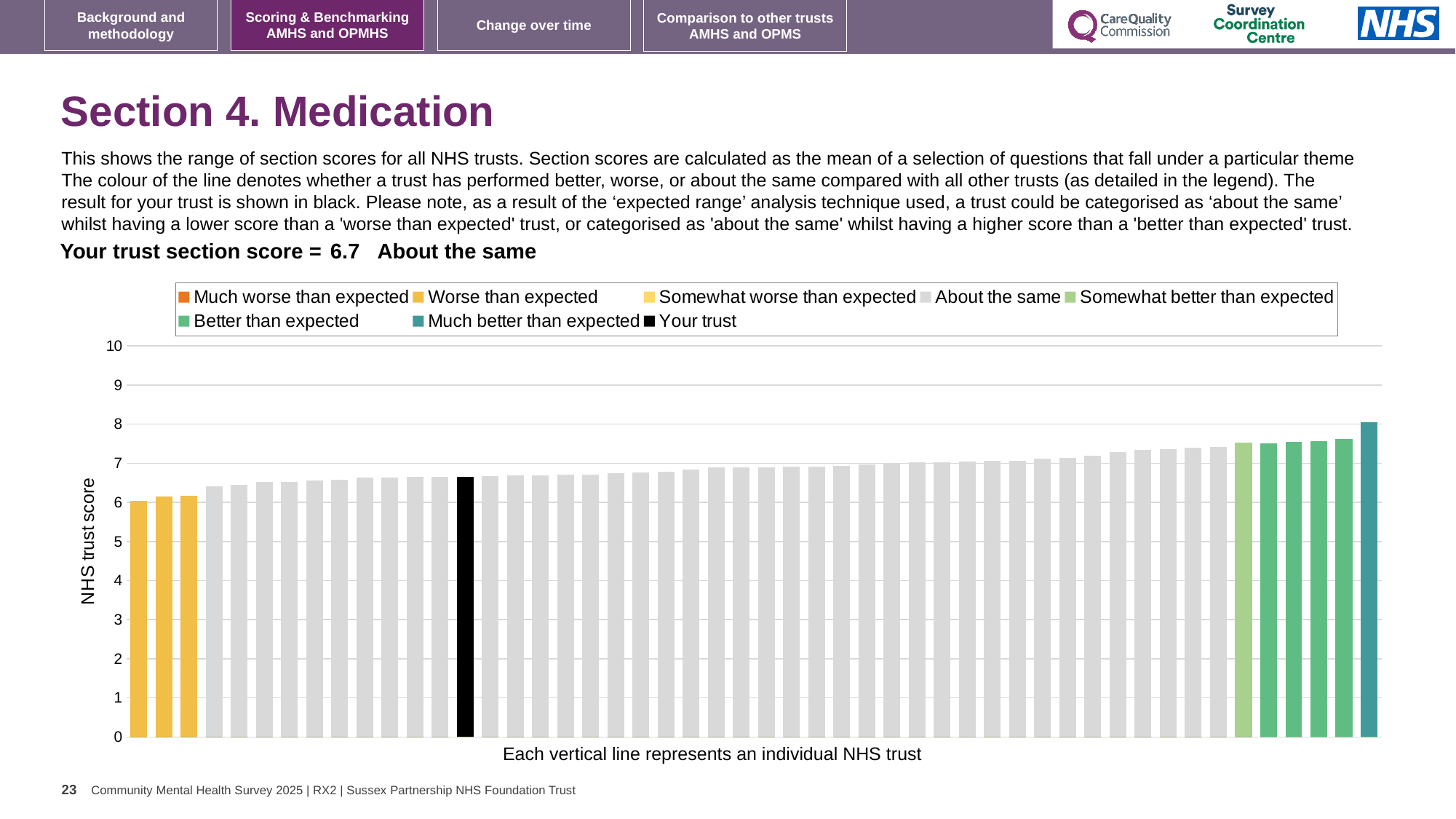
What is the section score for your trust shown on the slide? 6.7 What kind of chart is shown on the slide? Bar chart Is the value of the black bar (your trust) greater or less than 6? greater Do the bar values rise or fall from left to right along the x axis? rise What is the label on the y axis of the chart? NHS trust score How many bars are coloured as 'Worse than expected'? 3 Which legend category does the tallest bar belong to? Much better than expected Which category does your trust fall into according to the slide? About the same How many bars are coloured as 'Much better than expected'? 1 Is the value of the tallest bar in the chart greater or less than 7? greater How many entries does the chart legend list? 8 Is the value of the lowest bar in the chart greater or less than 7? less